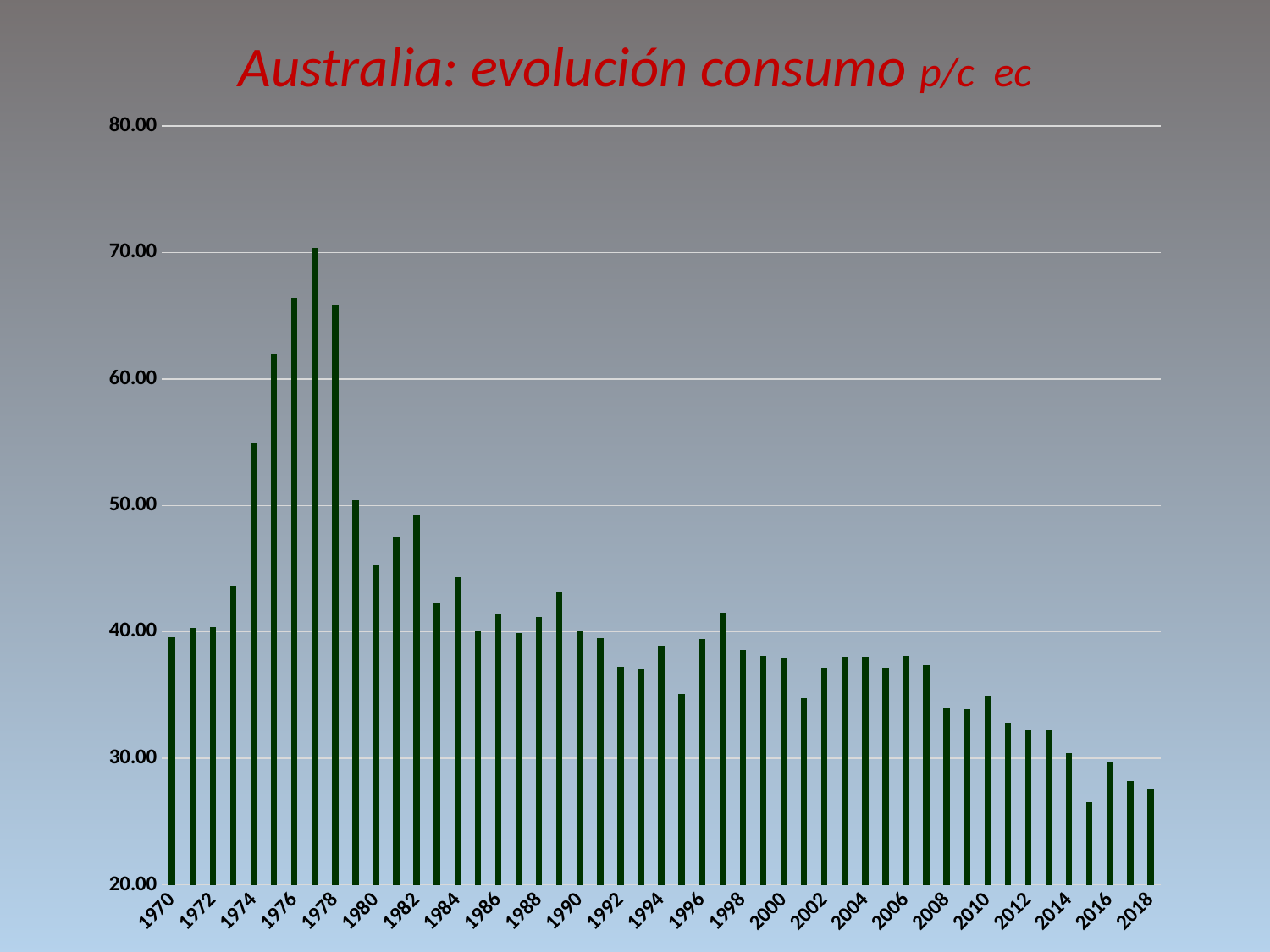
Is the value for 1978 greater or less than 60? greater What kind of chart is shown on the slide? bar chart Is the value for 2018 greater or less than 30? less What is the title of the chart? Australia: evolución consumo p/c ec Which is larger, the value for 1978 or the value for 1980? 1978 What colour are the bars in the chart? dark green Which is larger, the value for 2018 or the value for 1974? 1974 Is the value for 2012 greater or less than 40? less What is the highest value shown on the vertical axis? 80.00 Do the values generally rise or fall from 1980 to 2018? fall